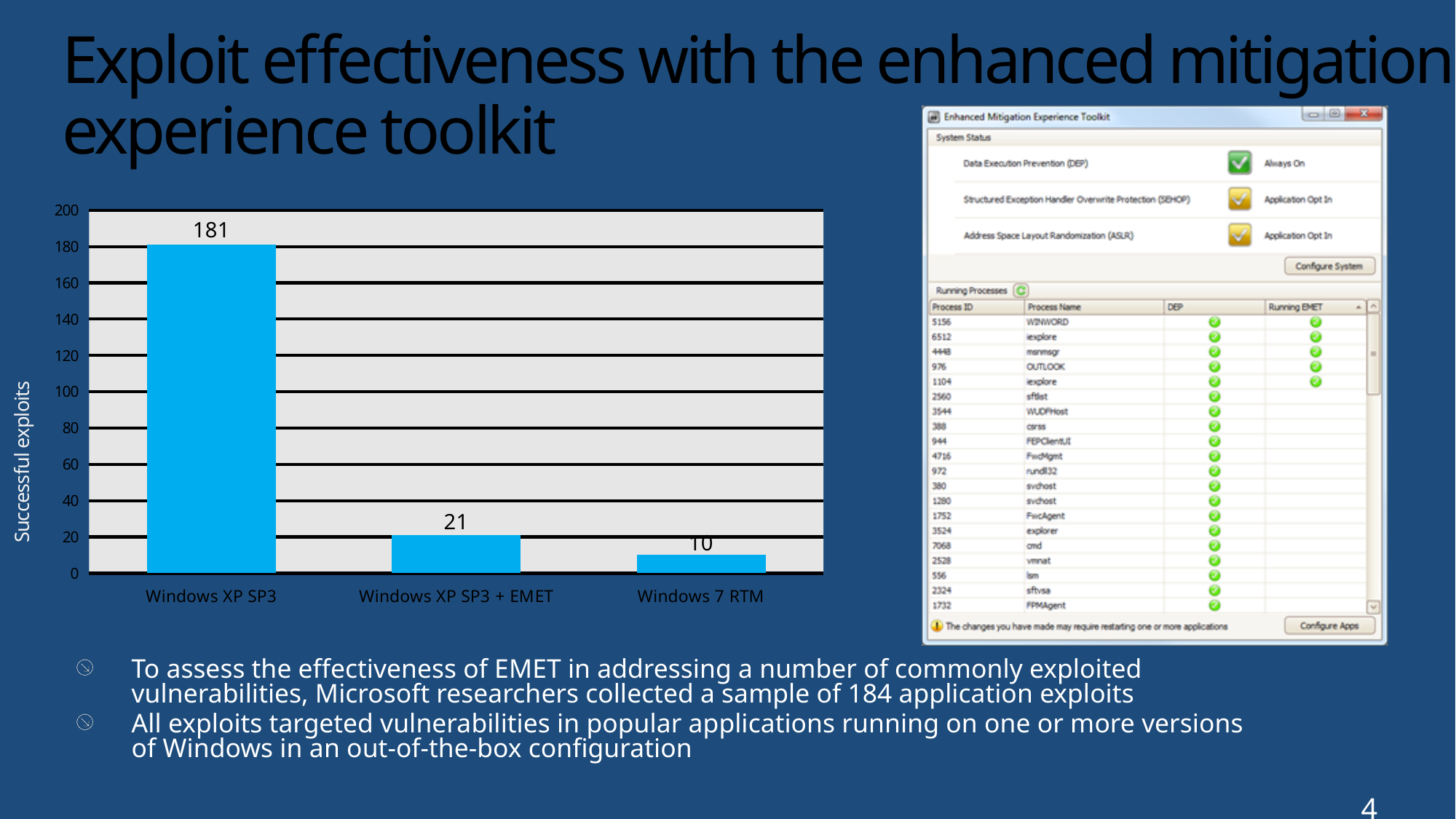
What is the label of the vertical axis of the chart? Successful exploits What is the number of successful exploits for Windows 7 RTM? 10 What is the difference in successful exploits between Windows XP SP3 + EMET and Windows 7 RTM? 11 What is the number of successful exploits for Windows XP SP3 + EMET? 21 What is the difference in successful exploits between Windows XP SP3 and Windows XP SP3 + EMET? 160 How many categories are shown on the x axis of the chart? 3 What kind of chart is shown on the slide? bar chart Which has more successful exploits, Windows XP SP3 + EMET or Windows 7 RTM? Windows XP SP3 + EMET Which category has the highest number of successful exploits? Windows XP SP3 Is the value for Windows XP SP3 greater or less than 160? greater Which category has the lowest number of successful exploits? Windows 7 RTM What is the number of successful exploits for Windows XP SP3? 181